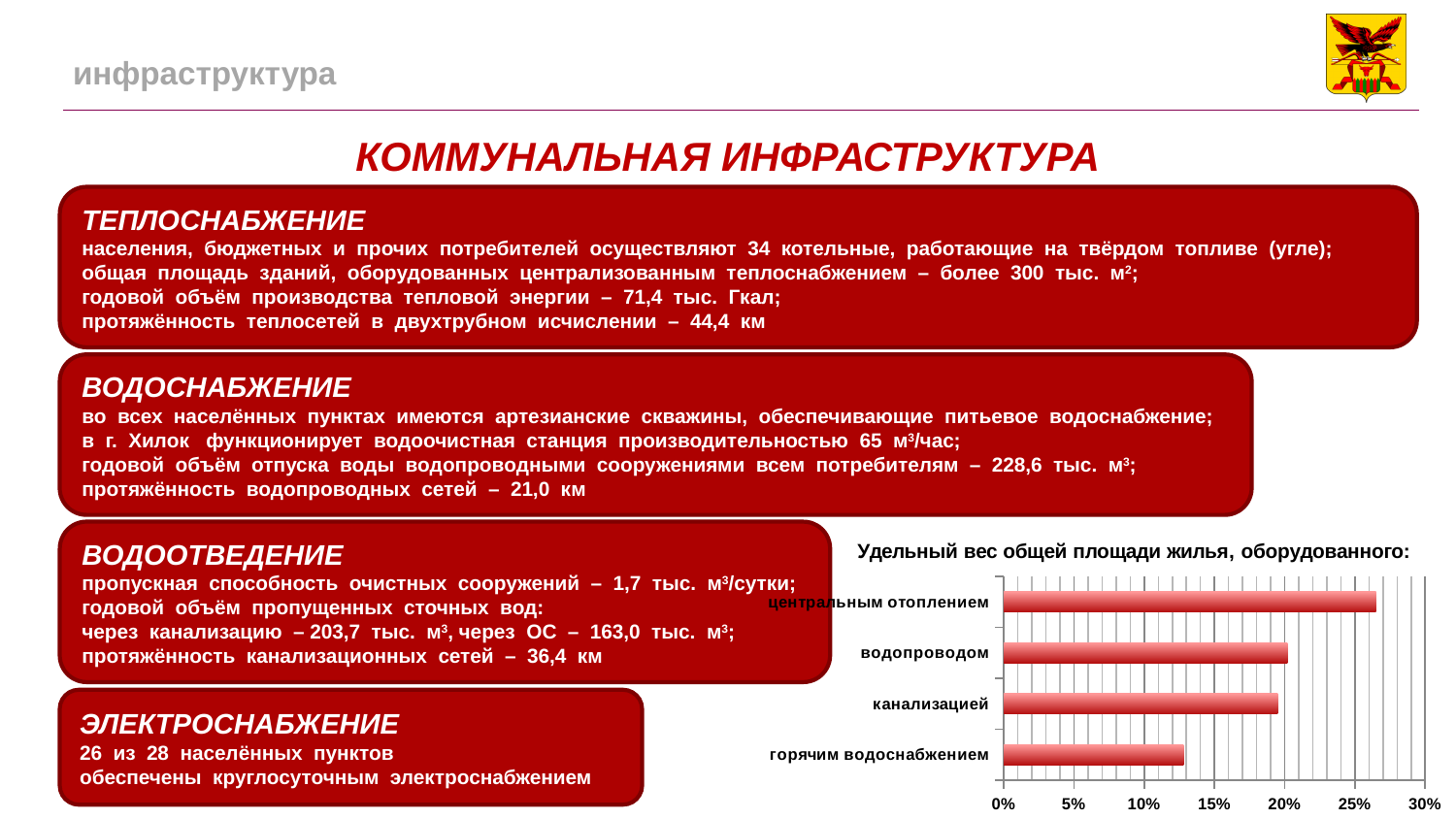
Is the value for горячим водоснабжением greater or less than 15%? less Which is larger, the value for водопроводом or the value for горячим водоснабжением? водопроводом Which is larger, the value for центральным отоплением or the value for горячим водоснабжением? центральным отоплением Which category has the highest value in the chart? центральным отоплением What kind of chart is shown on the slide? bar chart Is the value for канализацией greater or less than 15%? greater What is the title of the chart? Удельный вес общей площади жилья, оборудованного: What is the highest value shown on the chart's horizontal axis? 30% Which category has the lowest value in the chart? горячим водоснабжением Is the value for центральным отоплением greater or less than 25%? greater How many categories does the chart show? 4